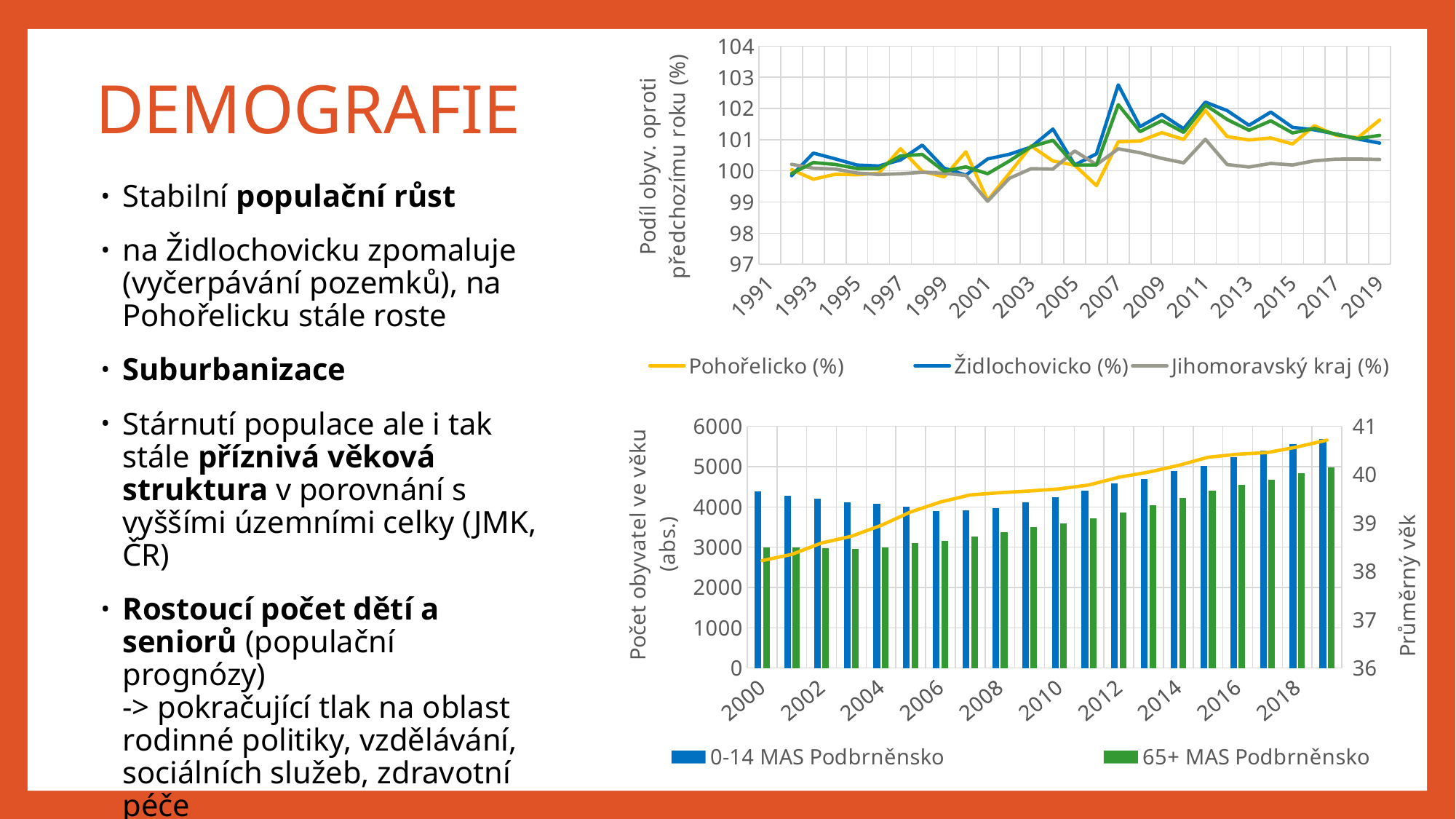
In the bottom chart, does the 65+ MAS Podbrněnsko series rise or fall from 2000 to 2019? rise In the bottom chart, which is larger in 2019: 0-14 MAS Podbrněnsko or 65+ MAS Podbrněnsko? 0-14 MAS Podbrněnsko How many series does the legend of the top chart list? 3 In the bottom chart, is the value for 0-14 MAS Podbrněnsko in 2019 greater or less than 5000? greater What kind of chart is the bottom chart on the slide? combination bar and line chart In the bottom chart, is the value for 65+ MAS Podbrněnsko in 2010 greater or less than 3000? greater In the top chart, is the value for Jihomoravský kraj (%) in 2001 greater or less than 100? less In the bottom chart, in which year is the 0-14 MAS Podbrněnsko value highest? 2019 How many series does the legend of the bottom chart list? 2 What kind of chart is the top chart on the slide? line chart